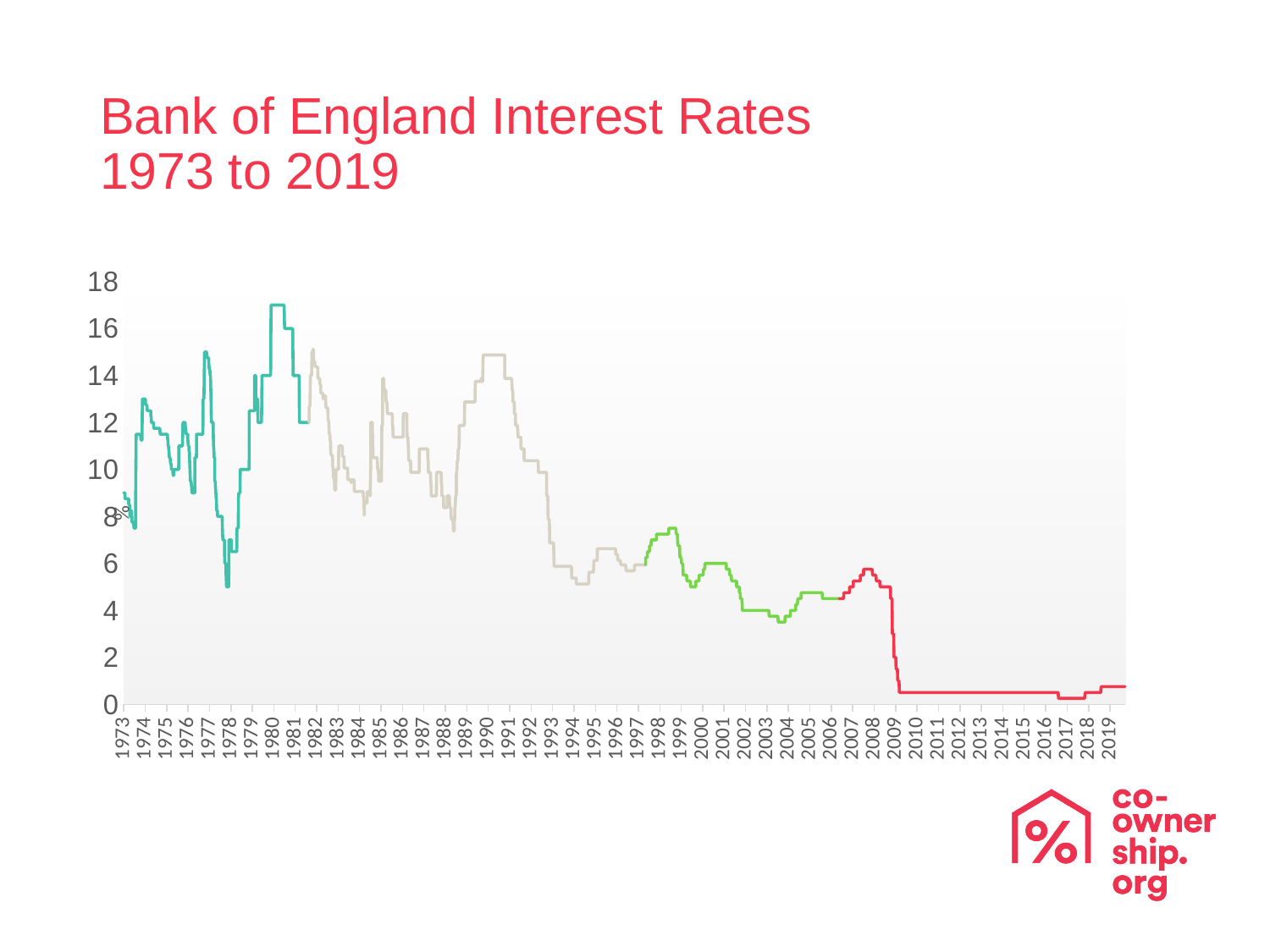
Is the interest rate in 2004 greater or less than 6? less Is the peak interest rate in 1990 greater or less than 14? greater Is the interest rate in 1994 greater or less than 8? less In which year does the interest rate reach its highest point? 1980 How many years are labelled along the x axis? 47 What is the highest value shown on the vertical axis? 18 What kind of chart is shown on the slide? line chart Overall, do interest rates rise or fall from 1973 to 2019? fall What is the title of the chart? Bank of England Interest Rates 1973 to 2019 Which year has the higher interest rate, 1980 or 2019? 1980